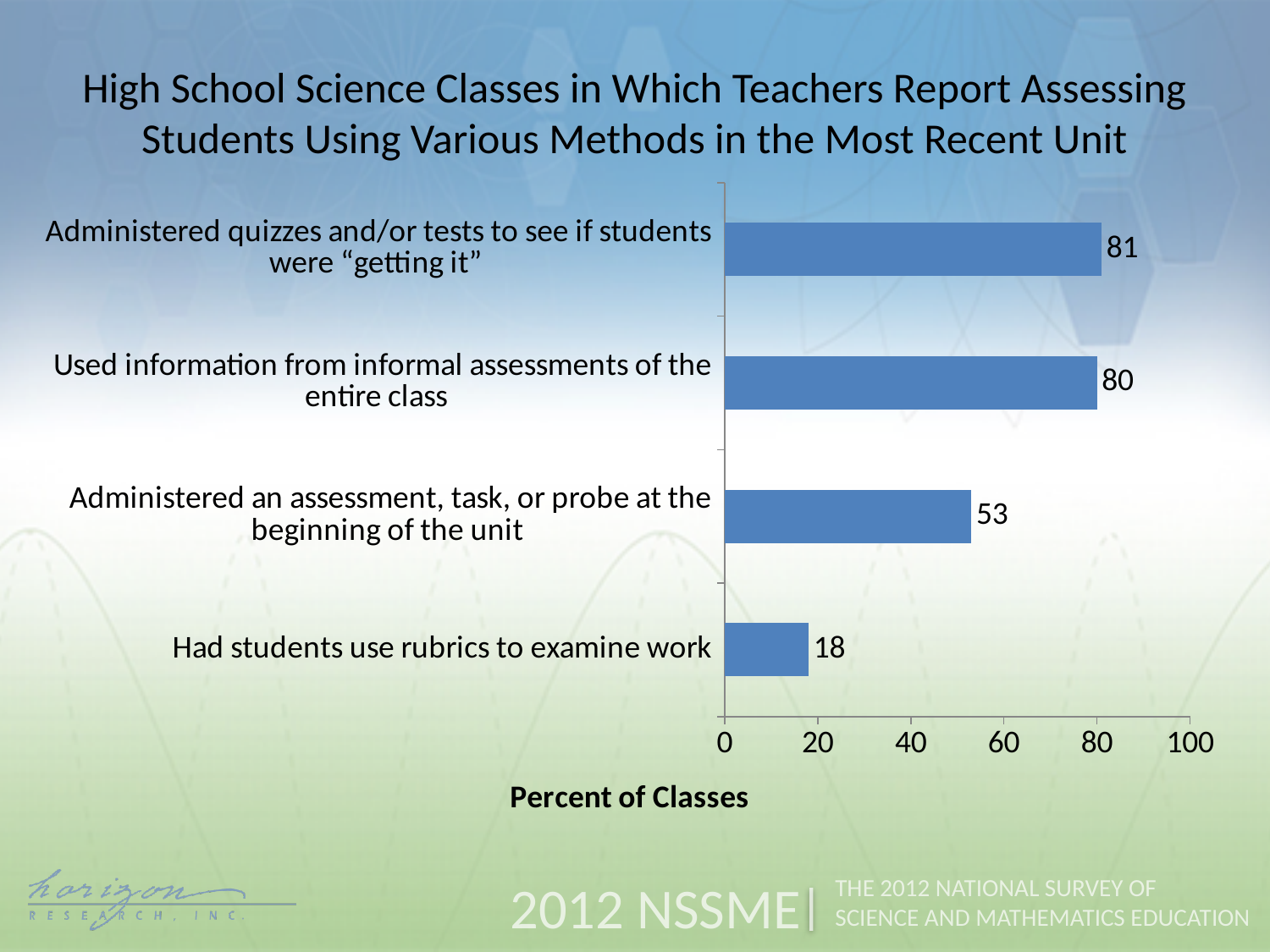
Which is larger: the percent of classes that administered an assessment at the beginning of the unit or the percent that had students use rubrics to examine work? Administered an assessment, task, or probe at the beginning of the unit What is the label of the horizontal axis? Percent of Classes What percent of classes administered an assessment, task, or probe at the beginning of the unit? 53 Which assessment method has the lowest percent of classes? Had students use rubrics to examine work Is the value for administering an assessment, task, or probe at the beginning of the unit greater or less than 40? greater Which assessment method has the highest percent of classes? Administered quizzes and/or tests to see if students were "getting it" What percent of classes used information from informal assessments of the entire class? 80 What is the difference in percent of classes between administering quizzes and/or tests and having students use rubrics to examine work? 63 What percent of classes had students use rubrics to examine work? 18 How many assessment methods are shown in the chart? 4 What is the difference in percent of classes between using information from informal assessments of the entire class and administering an assessment, task, or probe at the beginning of the unit? 27 What kind of chart is shown on the slide? Bar chart